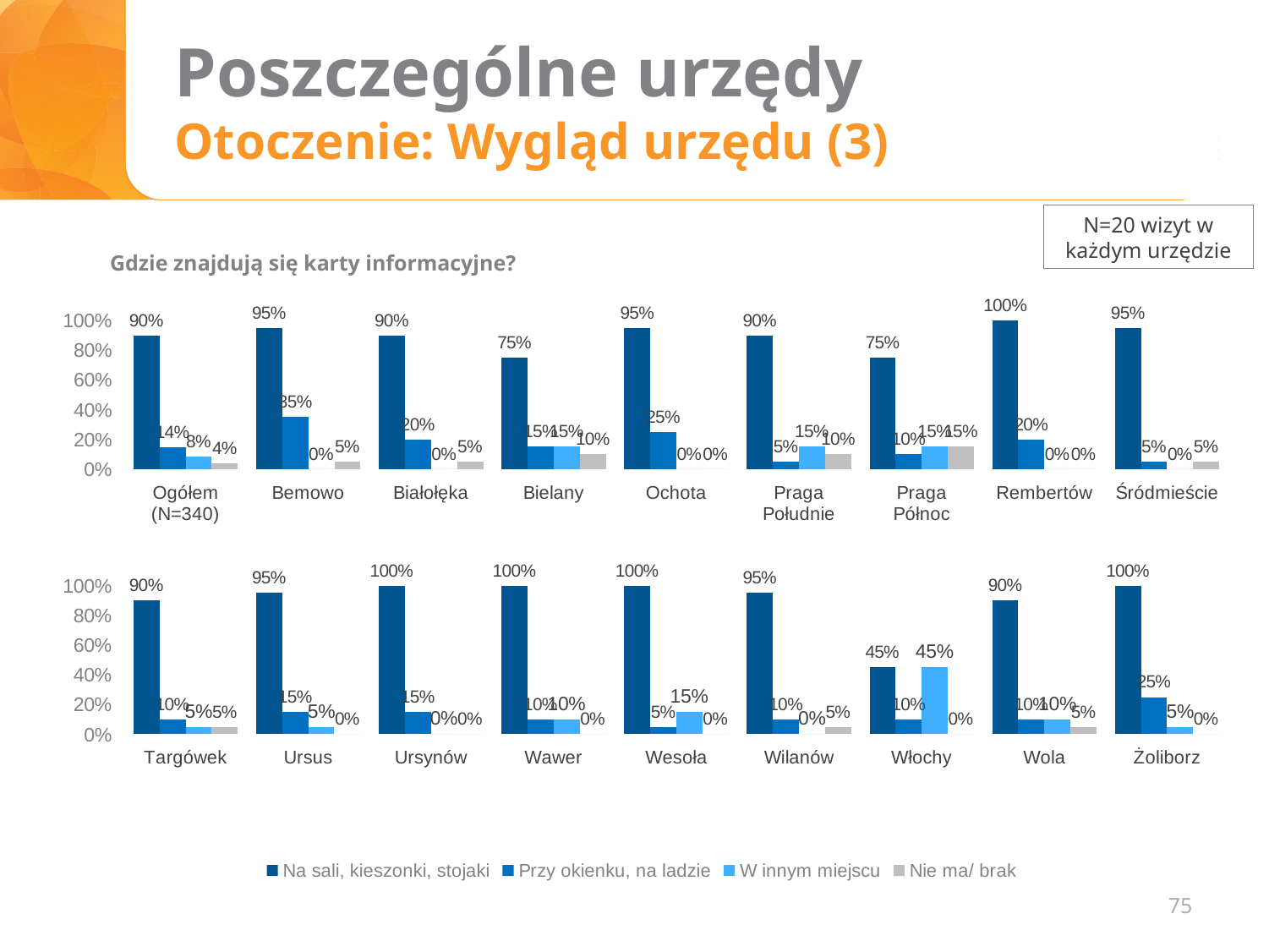
In the bottom chart, what is the value of 'W innym miejscu' for Włochy? 45% In the top chart, what is the difference between the 'Na sali, kieszonki, stojaki' values for Rembertów and Praga Północ? 25% What type of chart is used on this slide? Bar chart How many districts (categories) are shown in the bottom chart? 9 How many series does the legend list? 4 In the top chart, what is the value of 'Na sali, kieszonki, stojaki' for Bielany? 75% What is the question shown as the chart heading on the slide? Gdzie znajdują się karty informacyjne? In the top chart, which district has the highest value for 'Na sali, kieszonki, stojaki'? Rembertów In the top chart, what is the value of 'Przy okienku, na ladzie' for Bemowo? 35% In the bottom chart, which district has the lowest value for 'Na sali, kieszonki, stojaki'? Włochy In the top chart, what is the value of 'Nie ma/ brak' for Ogółem (N=340)? 4% In the bottom chart, which is larger: the 'Przy okienku, na ladzie' value for Żoliborz or for Ursus? Żoliborz